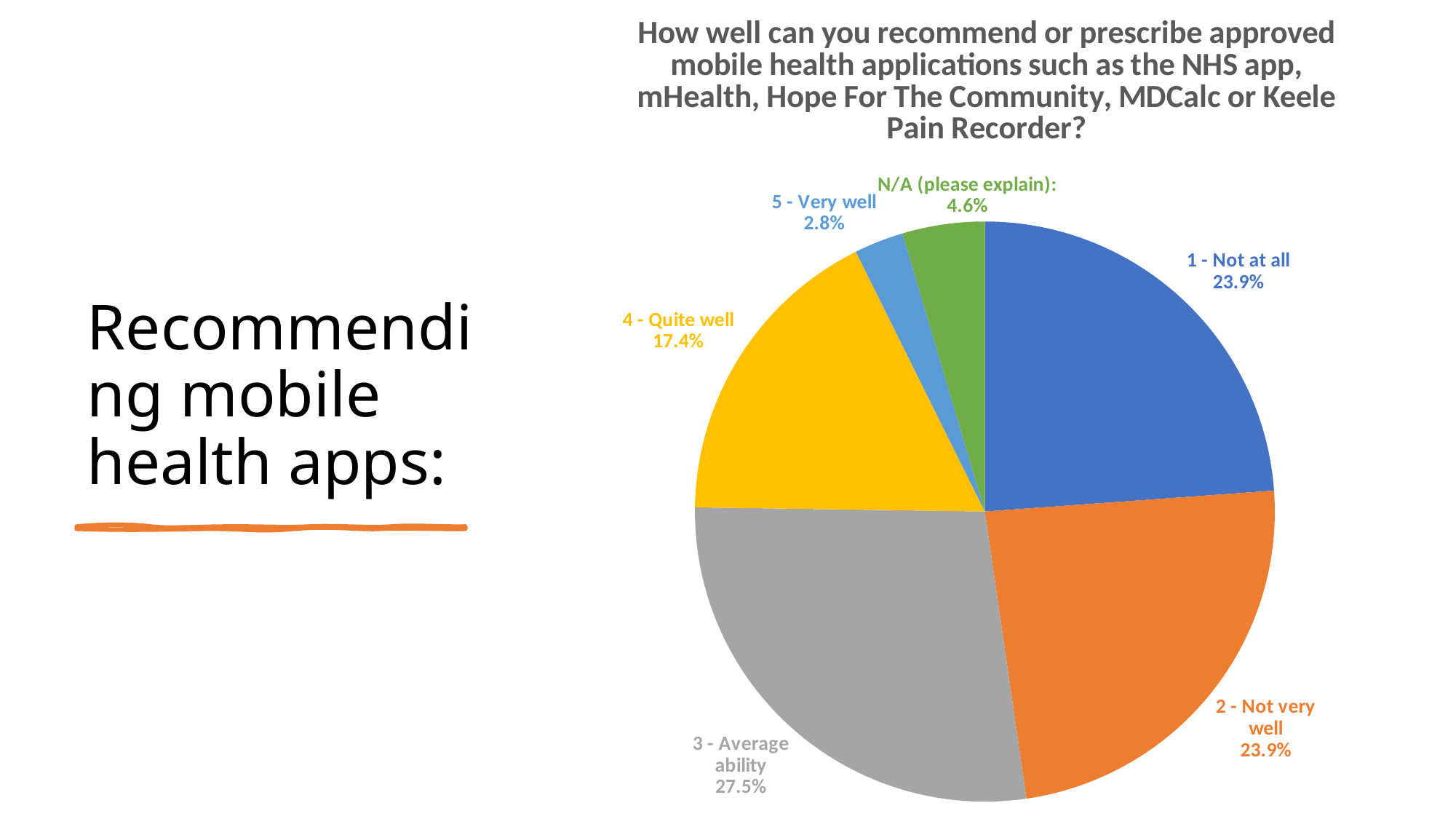
What is the combined share of '1 - Not at all' and '2 - Not very well'? 47.8% What percentage of respondents answered '3 - Average ability'? 27.5% What kind of chart is shown on the slide? Pie chart Which response category has the largest share of the pie? 3 - Average ability What percentage of respondents answered '4 - Quite well'? 17.4% How many categories are shown in the pie chart? 6 Which response category has the smallest share of the pie? 5 - Very well What percentage of respondents answered '5 - Very well'? 2.8% What percentage of respondents answered 'N/A (please explain):'? 4.6% Which is larger, the share for '4 - Quite well' or the share for 'N/A (please explain):'? 4 - Quite well What colour is the slice for '3 - Average ability'? Grey What is the difference in percentage points between '3 - Average ability' and '4 - Quite well'? 10.1